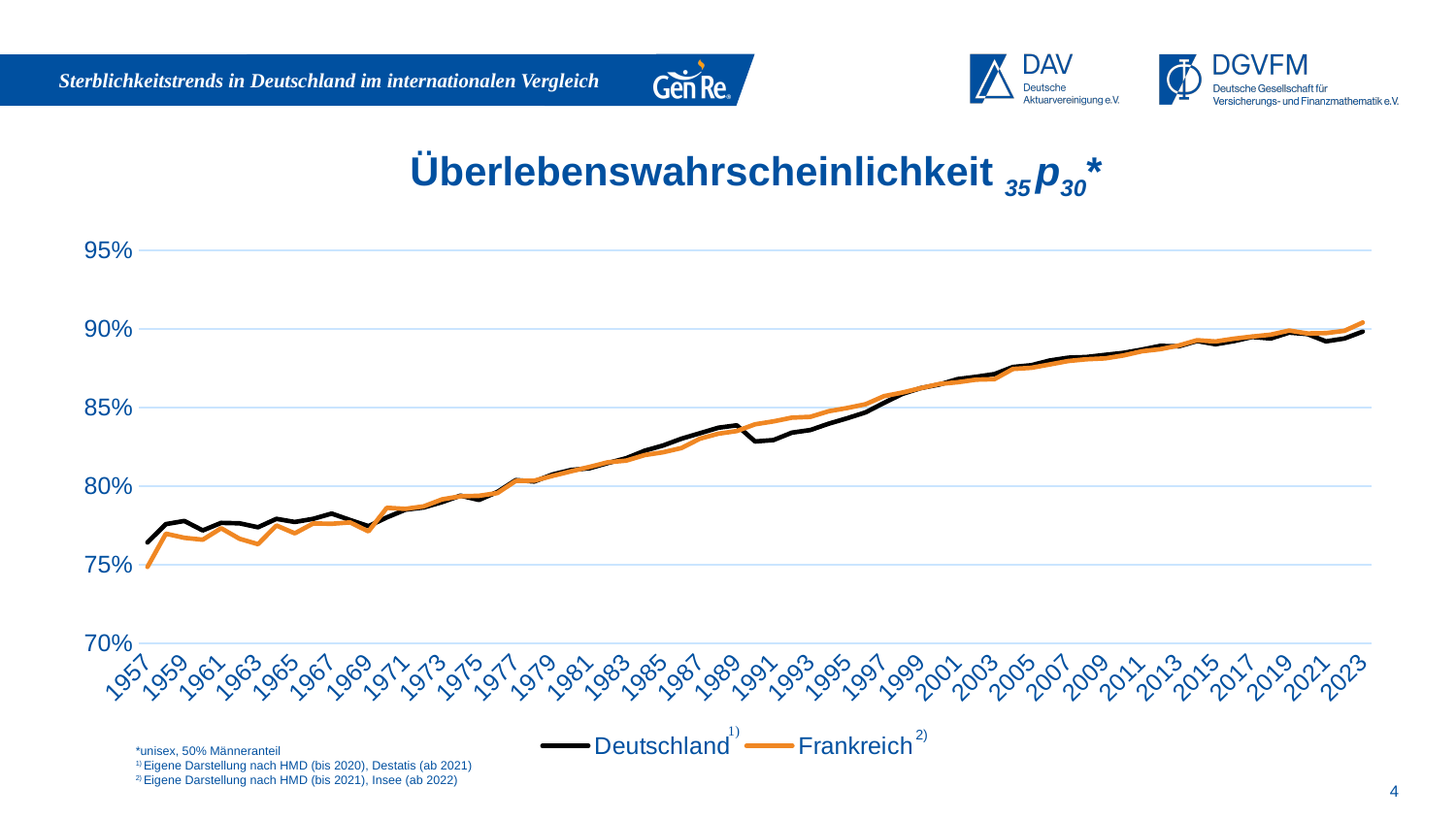
Is the value for Frankreich in 2009 greater or less than 85%? greater Which series has the higher value in 1963, Deutschland or Frankreich? Deutschland What colour is the Frankreich line? orange How many series does the legend list? 2 Which series has the higher value in 1991, Deutschland or Frankreich? Frankreich Which two series are shown in the legend? Deutschland and Frankreich Is the value for Deutschland in 1991 greater or less than 85%? less What kind of chart is shown on the slide? line chart Which series starts at the lower value in 1957? Frankreich Do the values for Deutschland generally rise or fall from 1957 to 2023? rise Is the value for Frankreich in 2023 greater or less than 90%? greater